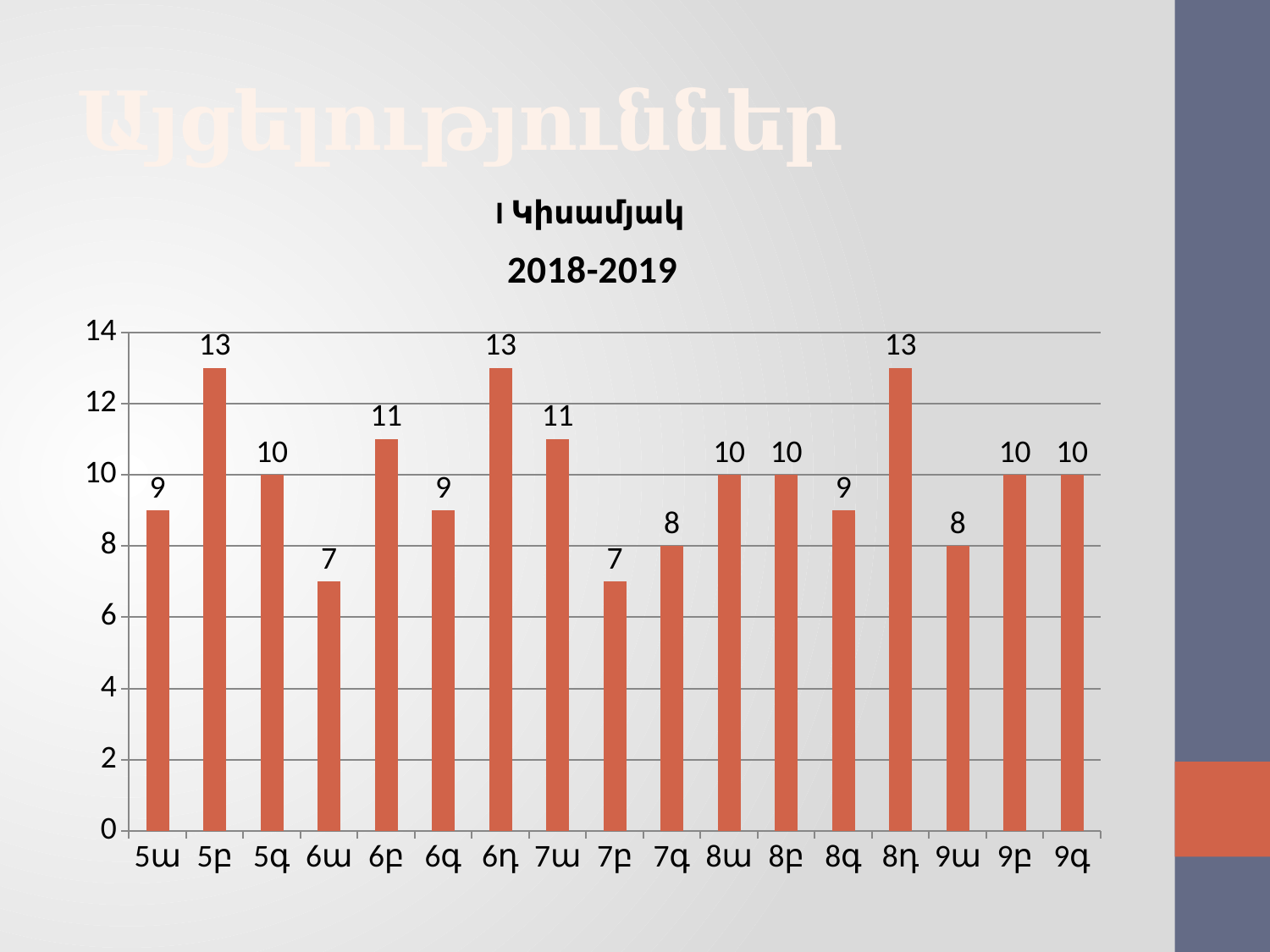
What is the value for 5բ? 13 What is the highest value shown on the chart? 13 Is the value for 8դ greater or less than 12? greater What is the value for 8գ? 9 Which has a larger value, 6բ or 7գ? 6բ What is the lowest value shown on the chart? 7 How many categories are shown on the x axis? 17 What is the value for 9ա? 8 What is the difference between the values for 6դ and 7բ? 6 What kind of chart is shown on the slide? Bar chart What is the value for 6ա? 7 What is the title of the chart? I Կիսամյակ 2018-2019